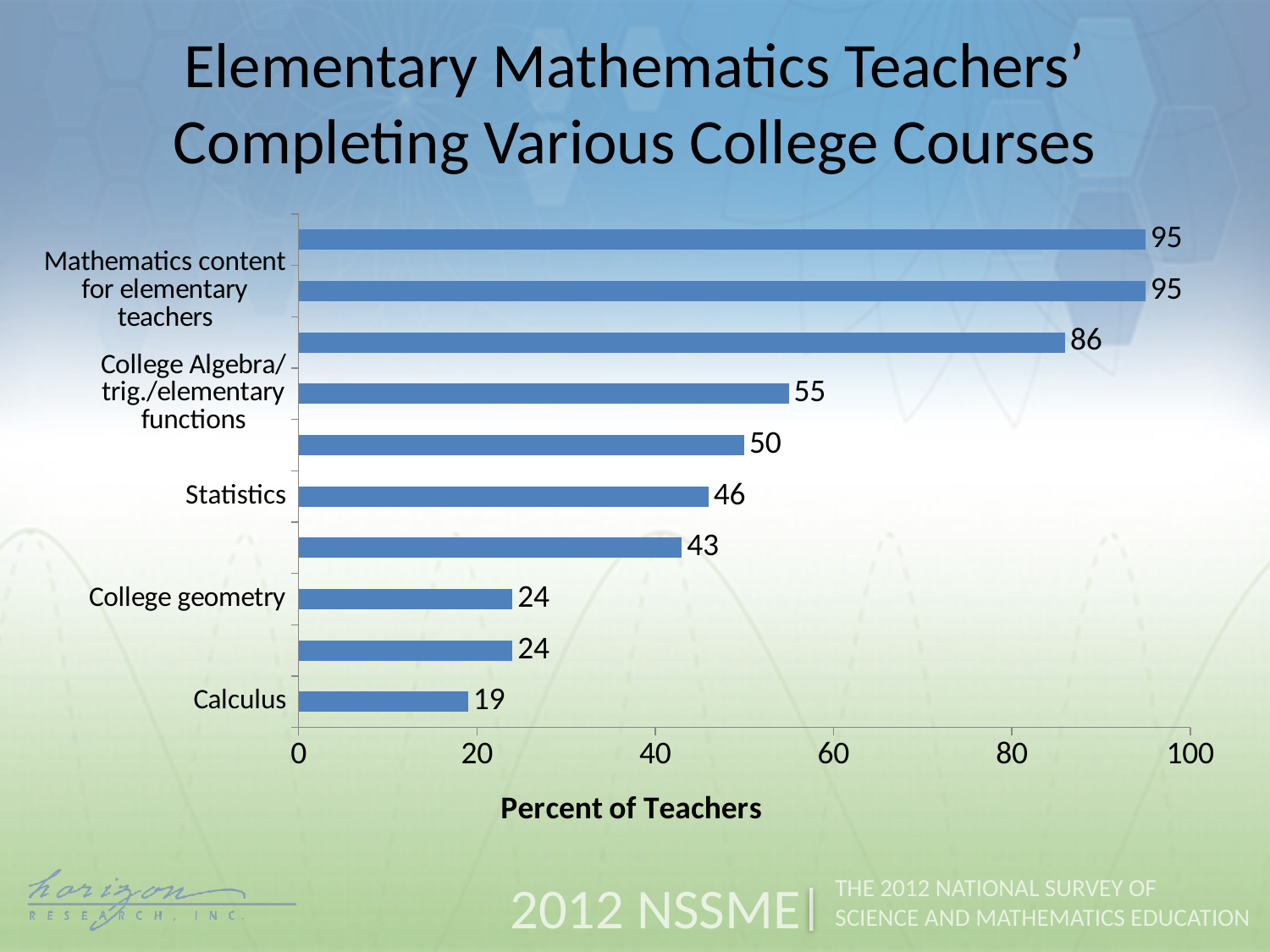
What is the value shown for Mathematics content for elementary teachers? 95 Which is larger, the value for Statistics or the value for College geometry? Statistics What is the value shown for Calculus? 19 What is the highest value shown on the chart? 95 Is the value for Calculus greater or less than 20? less How many bars are plotted on the chart? 10 Which labeled course has the lowest percentage of teachers? Calculus What is the title of the horizontal axis? Percent of Teachers What is the value shown for Statistics? 46 What percentage of teachers completed College Algebra/trig./elementary functions? 55 What is the value shown for College geometry? 24 What is the difference between the values for Statistics and Calculus? 27